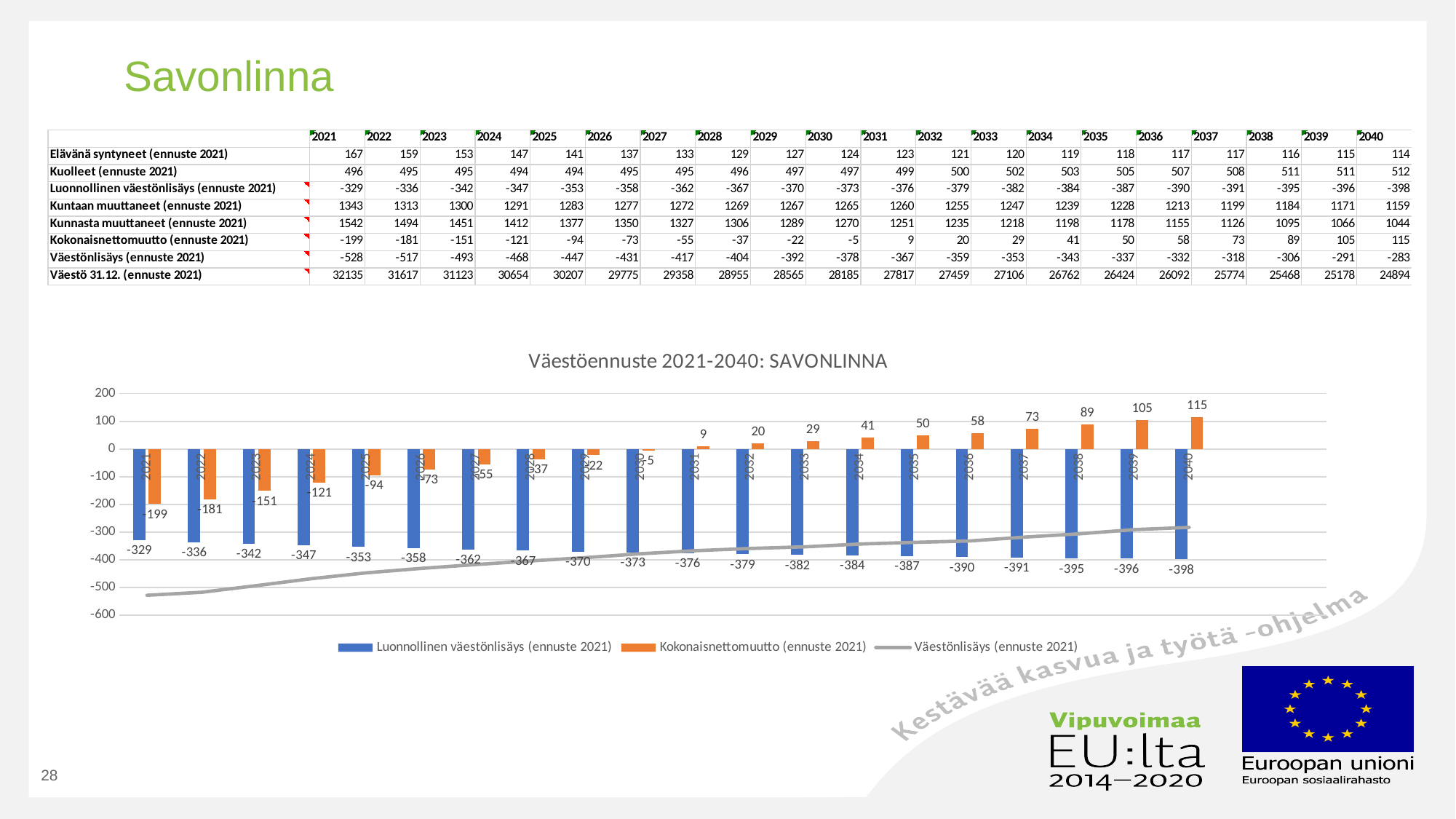
How many series does the chart legend list? 3 Is the Väestönlisäys (ennuste 2021) line value for 2021 greater or less than -500? less In which year is Luonnollinen väestönlisäys (ennuste 2021) lowest in the chart? 2040 How many years are plotted on the x axis of the chart? 20 Does Kokonaisnettomuutto (ennuste 2021) rise or fall from 2021 to 2040 in the chart? Rise Which is larger in the chart: Kokonaisnettomuutto for 2035 or for 2036? 2036 What is the value of Kokonaisnettomuutto (ennuste 2021) for 2031 in the chart? 9 What is the value of Kokonaisnettomuutto (ennuste 2021) for 2040 in the chart? 115 What is the difference between the Kokonaisnettomuutto values for 2040 and 2021 in the chart? 314 In which year is Kokonaisnettomuutto (ennuste 2021) highest in the chart? 2040 What type of chart is shown under the title 'Väestöennuste 2021-2040: SAVONLINNA'? Bar chart with a line What is the value of Luonnollinen väestönlisäys (ennuste 2021) for 2021 in the chart? -329